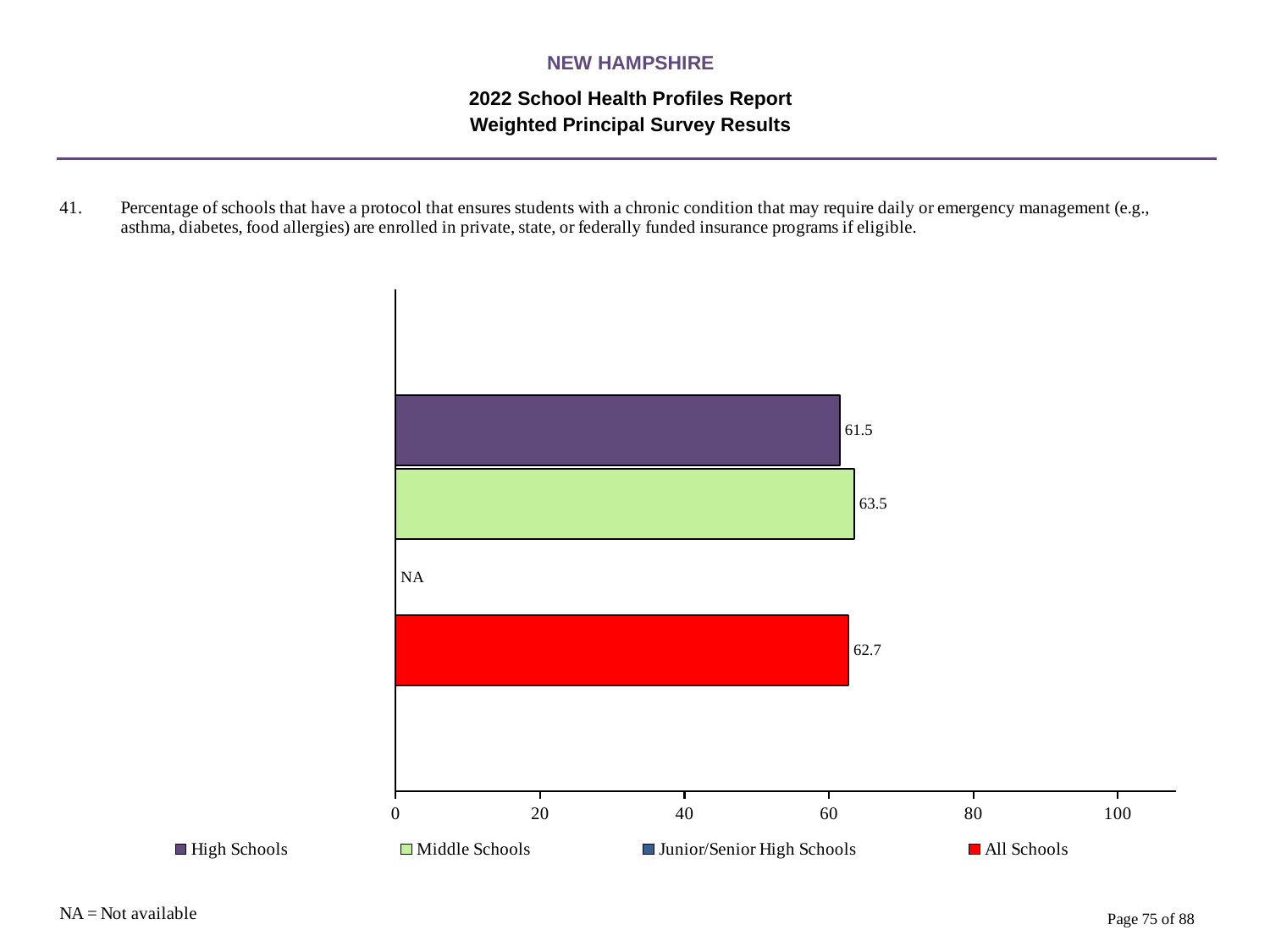
What is the value for Middle Schools? 63.5 What is the difference between the values for All Schools and High Schools? 1.2 How many series does the legend list? 4 What is the value for All Schools? 62.7 Which is larger, the value for Middle Schools or the value for All Schools? Middle Schools Is the value for High Schools greater or less than 60? greater What is the difference between the values for Middle Schools and High Schools? 2.0 What kind of chart is shown on the slide? bar chart Among the school types with a plotted value, which has the lowest value? High Schools What is shown for Junior/Senior High Schools? NA What is the value for High Schools? 61.5 Which school type has the highest value? Middle Schools